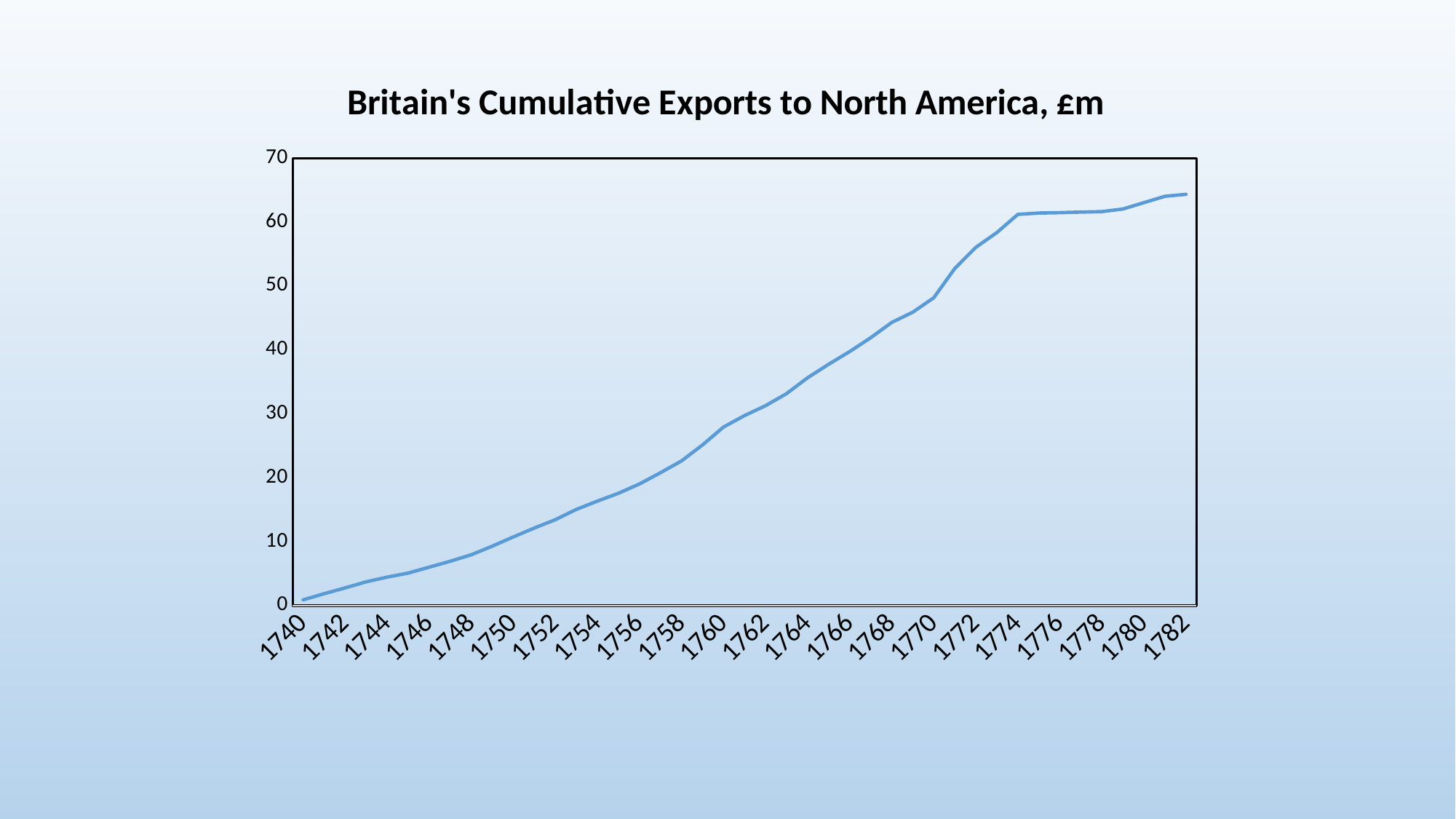
Which is larger, the value for 1760 or the value for 1770? 1770 Is the value for 1770 greater or less than 50? less What is the title of the chart? Britain's Cumulative Exports to North America, £m Do the values rise or fall from 1740 to 1782? rise Is the value for 1760 greater or less than 30? less Is the value for 1764 greater or less than 30? greater Which year has the highest value on the chart? 1782 Which year has the lowest value on the chart? 1740 What kind of chart is shown on the slide? line chart How many year labels are shown on the x axis? 22